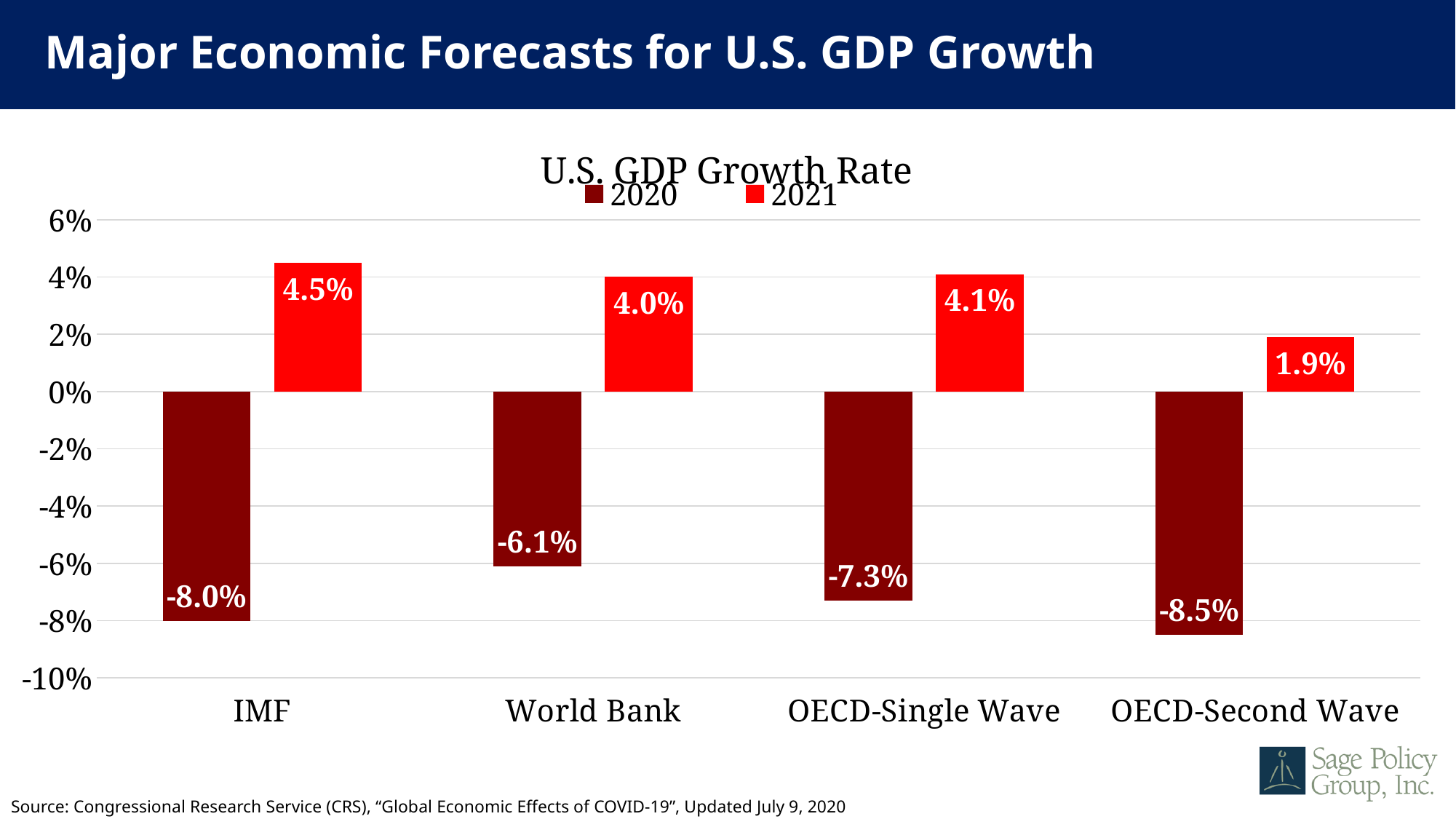
How many forecasters or scenarios are shown on the x axis? 4 What is the difference between the IMF's 2021 forecast and the OECD-Second Wave 2021 forecast? 2.6% Which forecast shows the lowest 2020 GDP growth rate? OECD-Second Wave What is the title of the chart? U.S. GDP Growth Rate What is the 2020 GDP growth forecast for the OECD-Second Wave scenario? -8.5% What is the 2021 GDP growth forecast from the World Bank? 4.0% What is the 2021 GDP growth forecast for the OECD-Single Wave scenario? 4.1% What type of chart is shown on the slide? Bar chart Which is larger, the World Bank's 2020 forecast or the OECD-Single Wave 2020 forecast? World Bank How many series does the legend list? 2 What is the 2020 GDP growth forecast from the IMF? -8.0% Which forecaster has the highest 2021 GDP growth forecast? IMF